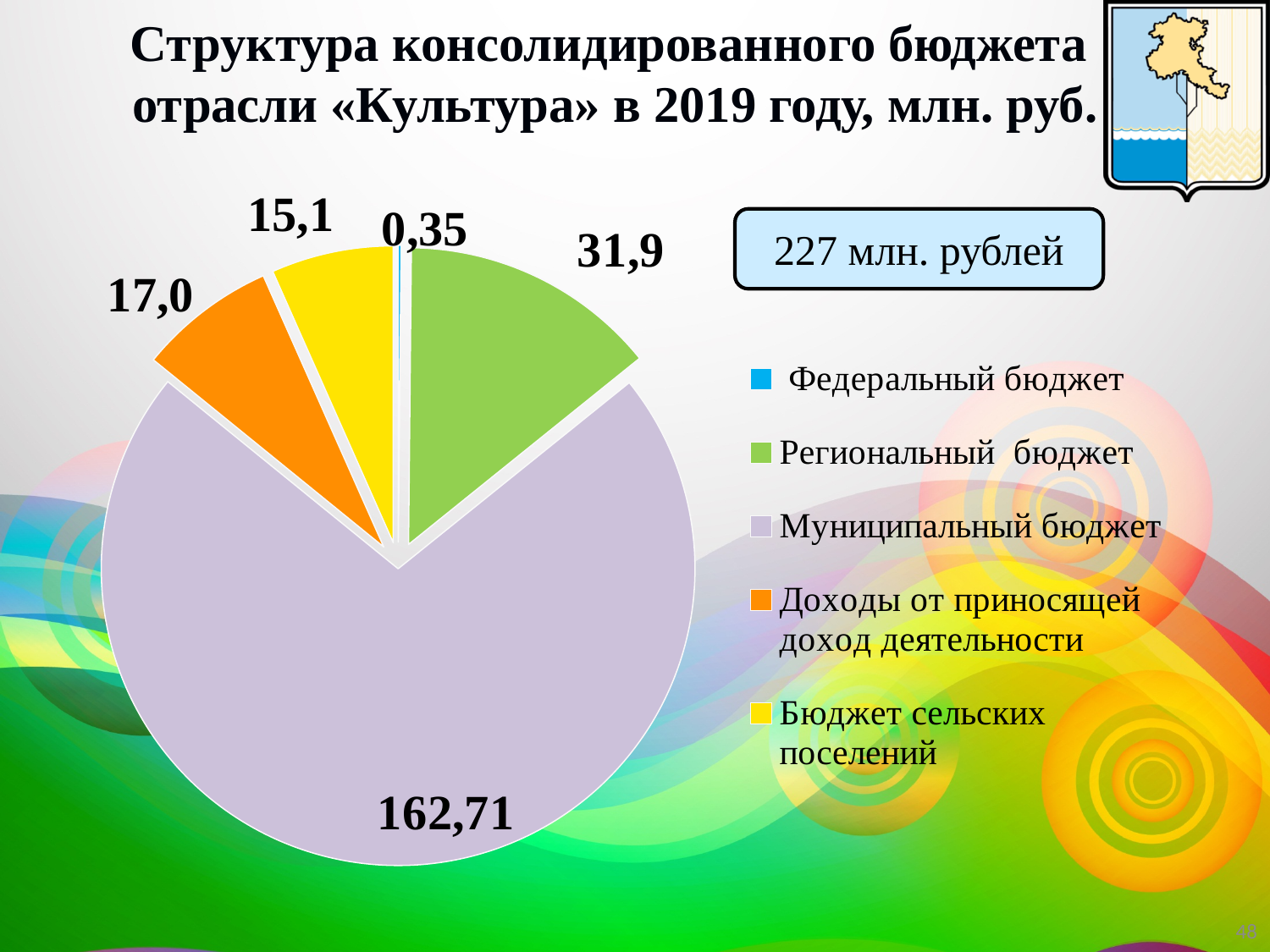
What value is shown for Федеральный бюджет on the pie chart? 0,35 Which category has the largest slice of the pie chart? Муниципальный бюджет What is the difference between the values for Доходы от приносящей доход деятельности and Бюджет сельских поселений? 1,9 What value is shown for Муниципальный бюджет on the pie chart? 162,71 How many categories does the pie chart show? 5 Which category has the smallest slice of the pie chart? Федеральный бюджет What is the difference between the values for Муниципальный бюджет and Региональный бюджет? 130,81 What value is shown for Бюджет сельских поселений on the pie chart? 15,1 What type of chart is shown on the slide? Pie chart What value is shown for Доходы от приносящей доход деятельности on the pie chart? 17,0 Which is larger: Доходы от приносящей доход деятельности or Бюджет сельских поселений? Доходы от приносящей доход деятельности What value is shown for Региональный бюджет on the pie chart? 31,9